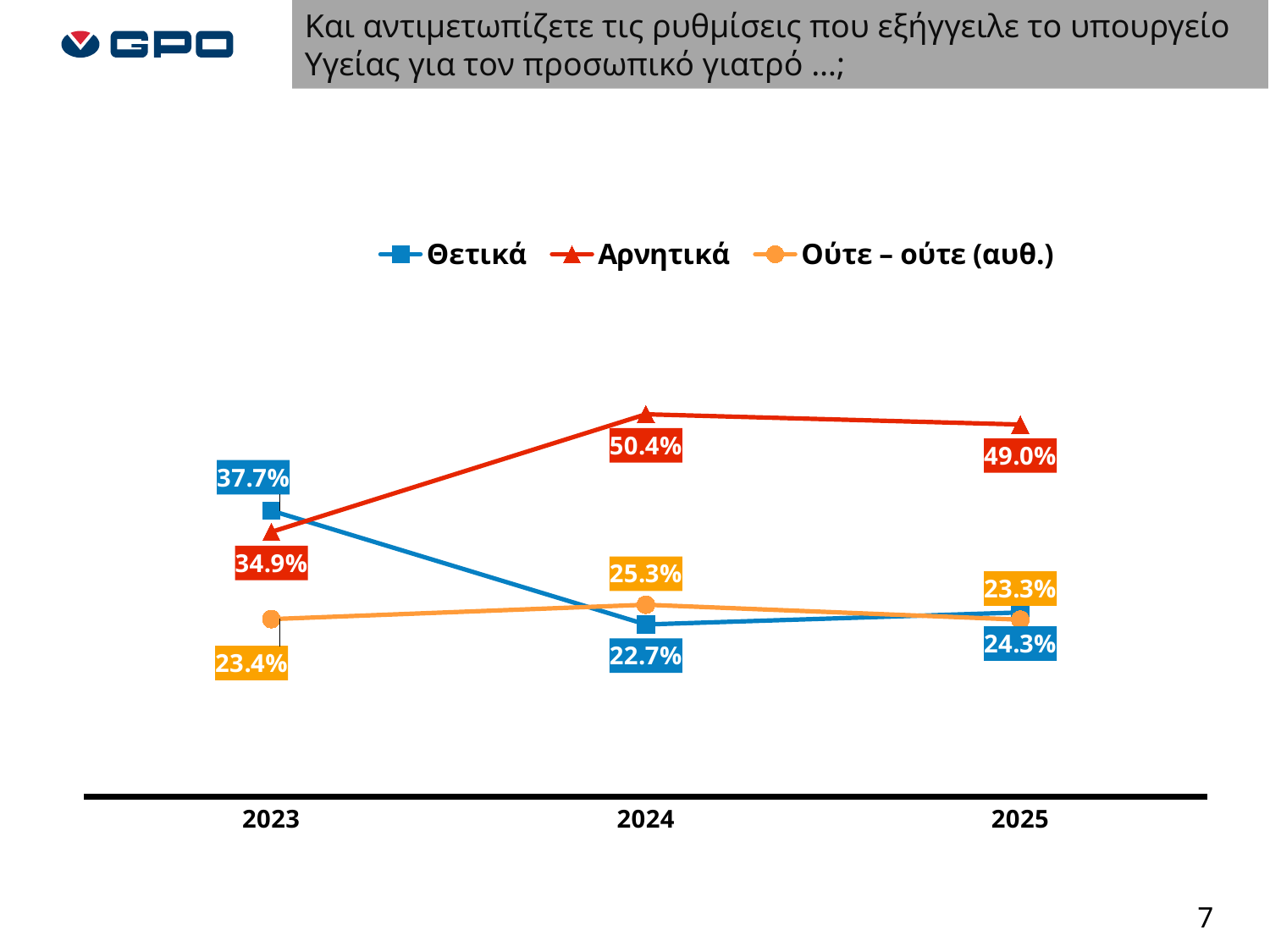
What is the value for Ούτε – ούτε (αυθ.) in 2025? 23.3% What is the value for Θετικά in 2023? 37.7% Does the Θετικά series rise or fall from 2023 to 2024? Fall What is the value for Θετικά in 2025? 24.3% What is the difference between the Αρνητικά values in 2024 and 2025? 1.4% Which is larger in 2023, Θετικά or Αρνητικά? Θετικά How many series does the legend list? 3 In which year is the Θετικά series lowest? 2024 What kind of chart is shown on the slide? Line chart What is the value for Αρνητικά in 2024? 50.4% What is the difference between Αρνητικά and Θετικά in 2024? 27.7% In which year is the Αρνητικά series highest? 2024